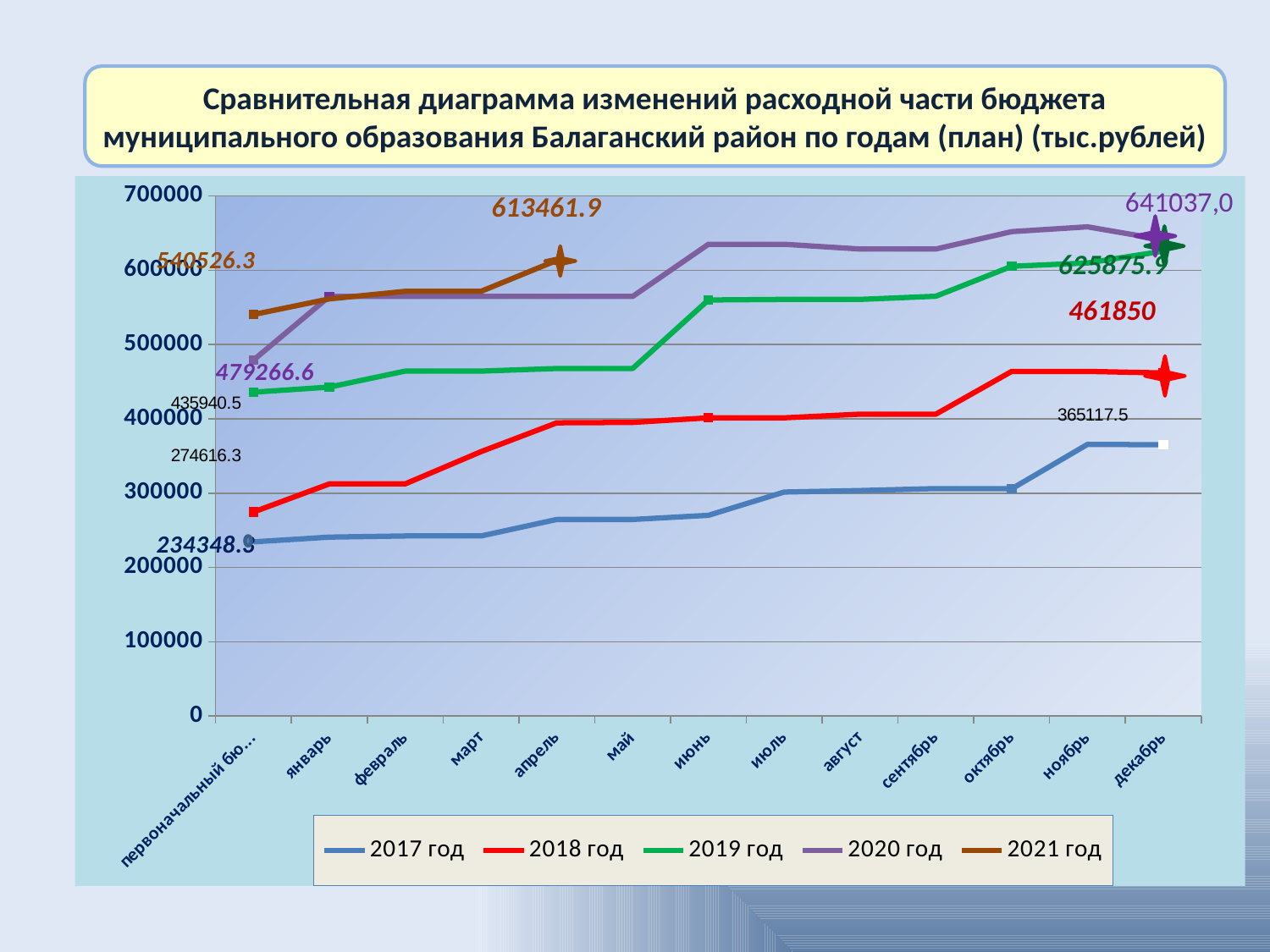
How many series does the legend list? 5 What is the difference between the декабрь value and the first (первоначальный) value for 2017 год? 130769.2 Which series has the higher value in декабрь, 2020 год or 2019 год? 2020 год What is the value for 2019 год in декабрь? 625875.9 What is the value for 2020 год in декабрь? 641037,0 What is the value for 2021 год in апрель? 613461.9 What kind of chart is shown on the slide? line chart How many categories are shown on the x axis? 13 What is the value for 2018 год in декабрь? 461850 Which series has the lowest value in декабрь? 2017 год What is the value for 2017 год in декабрь? 365117.5 Is the value for 2020 год in июнь greater or less than 600000? greater